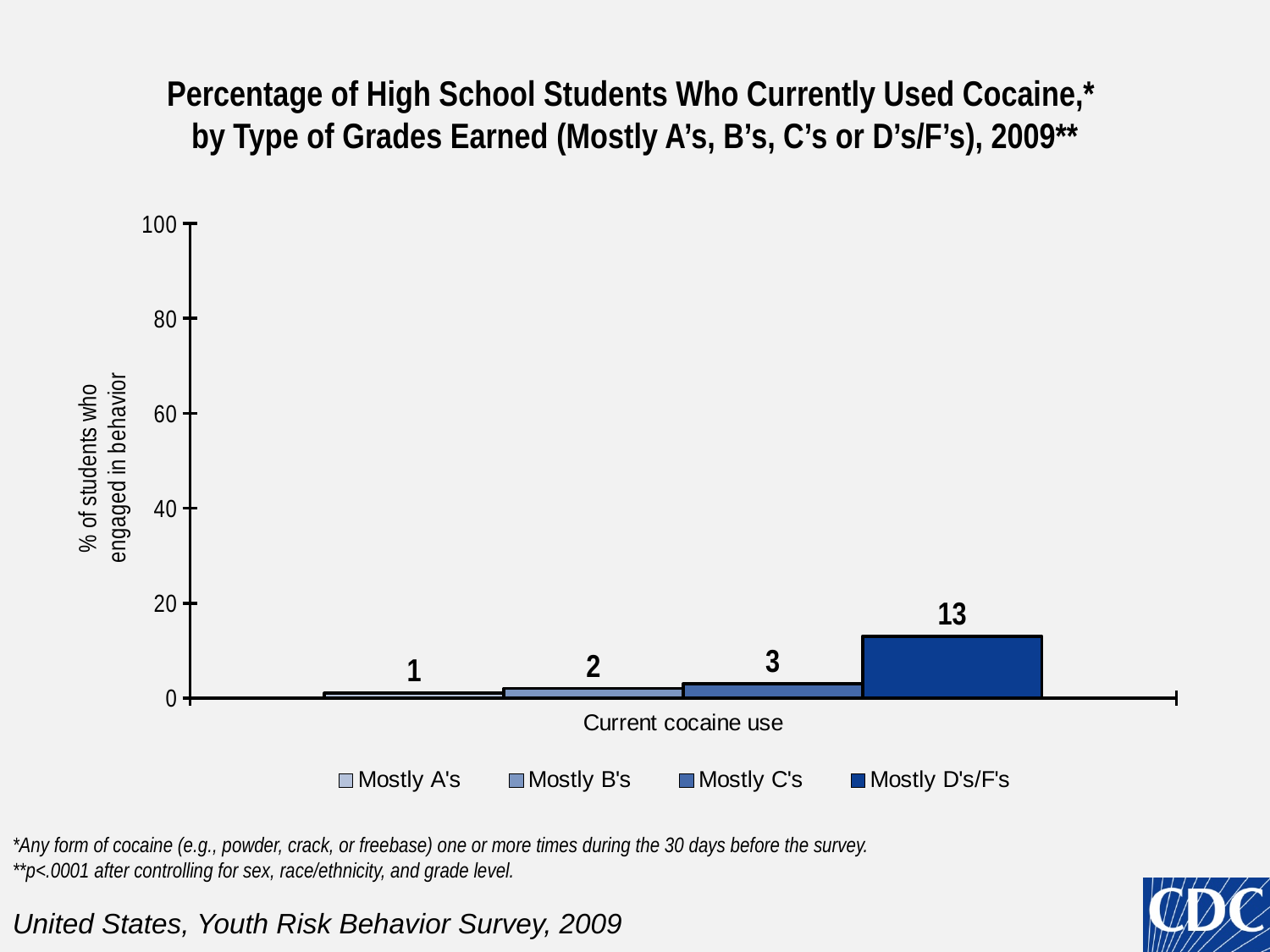
How many series does the legend list? 4 What is the difference between the values for Mostly D's/F's and Mostly B's? 11 Which grade group has the highest percentage of current cocaine use? Mostly D's/F's Do the values rise or fall from Mostly A's to Mostly D's/F's? rise What is the value for Mostly C's? 3 What is the label on the x axis of the chart? Current cocaine use What percentage of students with Mostly A's currently used cocaine? 1 Which grade group has the lowest percentage of current cocaine use? Mostly A's Is the value for Mostly D's/F's greater or less than 20? less Which is larger, the value for Mostly C's or the value for Mostly B's? Mostly C's What percentage of students with Mostly D's/F's currently used cocaine? 13 What kind of chart is shown on the slide? bar chart